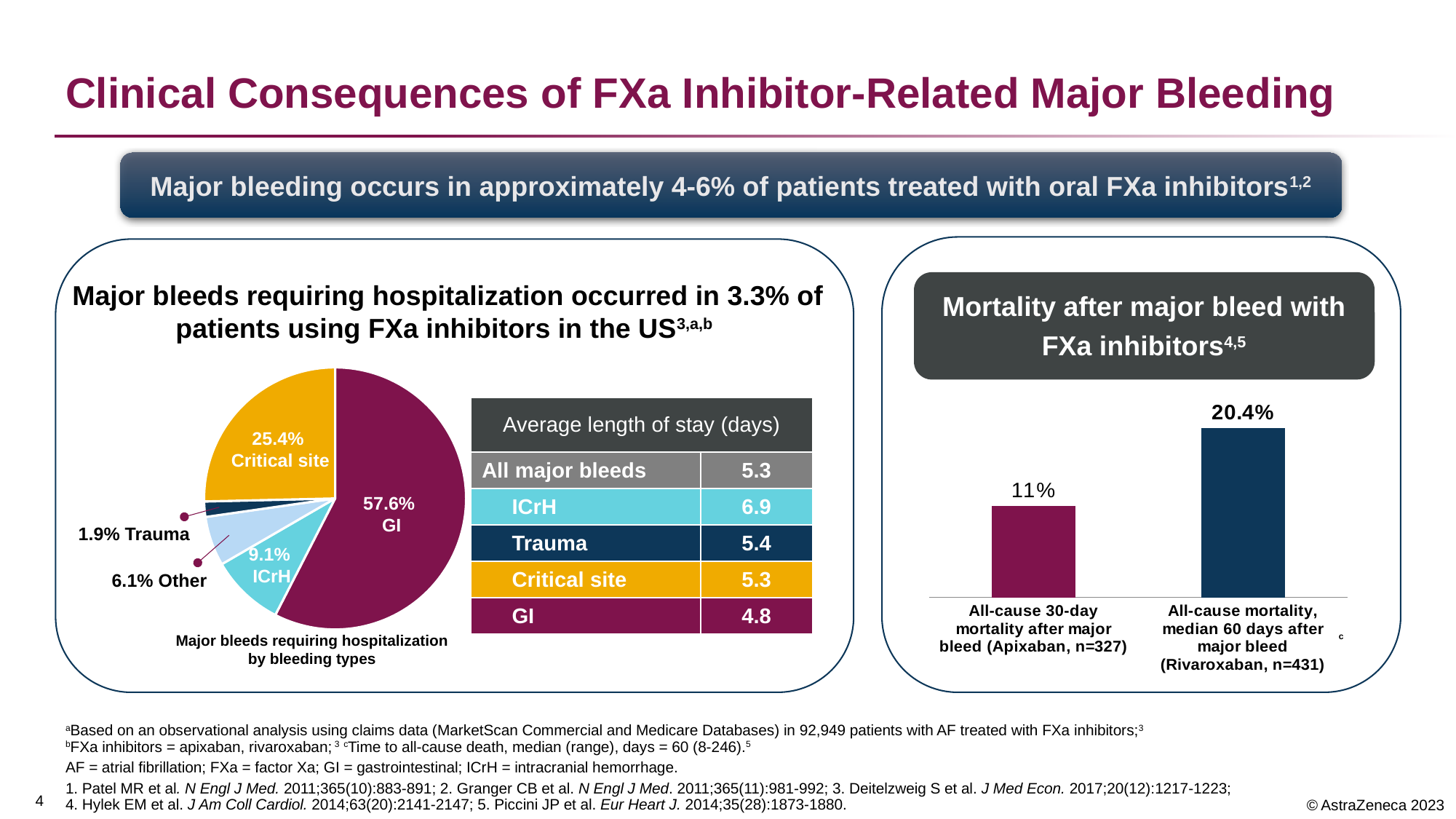
In the pie chart of major bleeds requiring hospitalization by bleeding types, which bleeding type has the largest slice? GI In the 'Mortality after major bleed with FXa inhibitors' bar chart, what is the all-cause 30-day mortality after major bleed for Apixaban (n=327)? 11% In the pie chart of major bleeds requiring hospitalization by bleeding types, what share is ICrH? 9.1% What kind of chart is used in the 'Mortality after major bleed with FXa inhibitors' panel? Bar chart In the pie chart of major bleeds requiring hospitalization by bleeding types, what share is GI? 57.6% In the pie chart of major bleeds requiring hospitalization by bleeding types, which is larger, the Other slice or the Trauma slice? Other In the 'Mortality after major bleed with FXa inhibitors' bar chart, what is the all-cause mortality at median 60 days after major bleed for Rivaroxaban (n=431)? 20.4% In the pie chart of major bleeds requiring hospitalization by bleeding types, how many slices are there? 5 In the 'Mortality after major bleed with FXa inhibitors' bar chart, what is the difference between the Rivaroxaban and Apixaban mortality values? 9.4% In the pie chart of major bleeds requiring hospitalization by bleeding types, what share is Critical site? 25.4% In the pie chart of major bleeds requiring hospitalization by bleeding types, what is the difference between the GI share and the Critical site share? 32.2% In the pie chart of major bleeds requiring hospitalization by bleeding types, which bleeding type has the smallest slice? Trauma